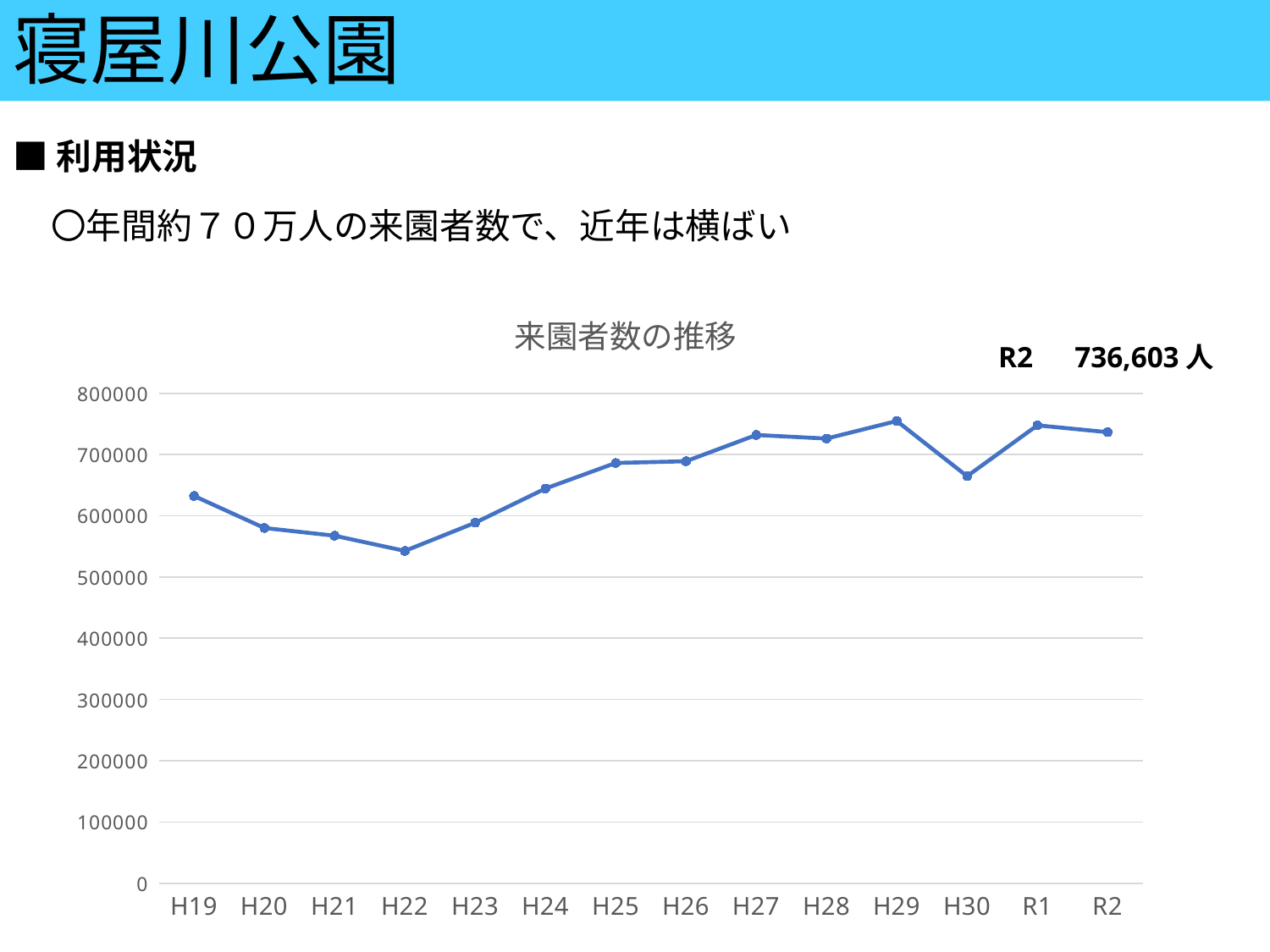
What is the title of the chart? 来園者数の推移 Which is larger, the value for H29 or the value for H30? H29 Is the value for H19 greater or less than 600000? greater Which year has the lowest number of visitors? H22 What is the number of visitors for R2 as printed on the slide? 736,603 人 Is the value for H22 greater or less than 600000? less Which is larger, the value for H24 or the value for H25? H25 Is the value for H27 greater or less than 700000? greater How many data points are plotted on the chart? 14 Do the values rise or fall from H22 to H29? rise What kind of chart is shown on the slide? line chart